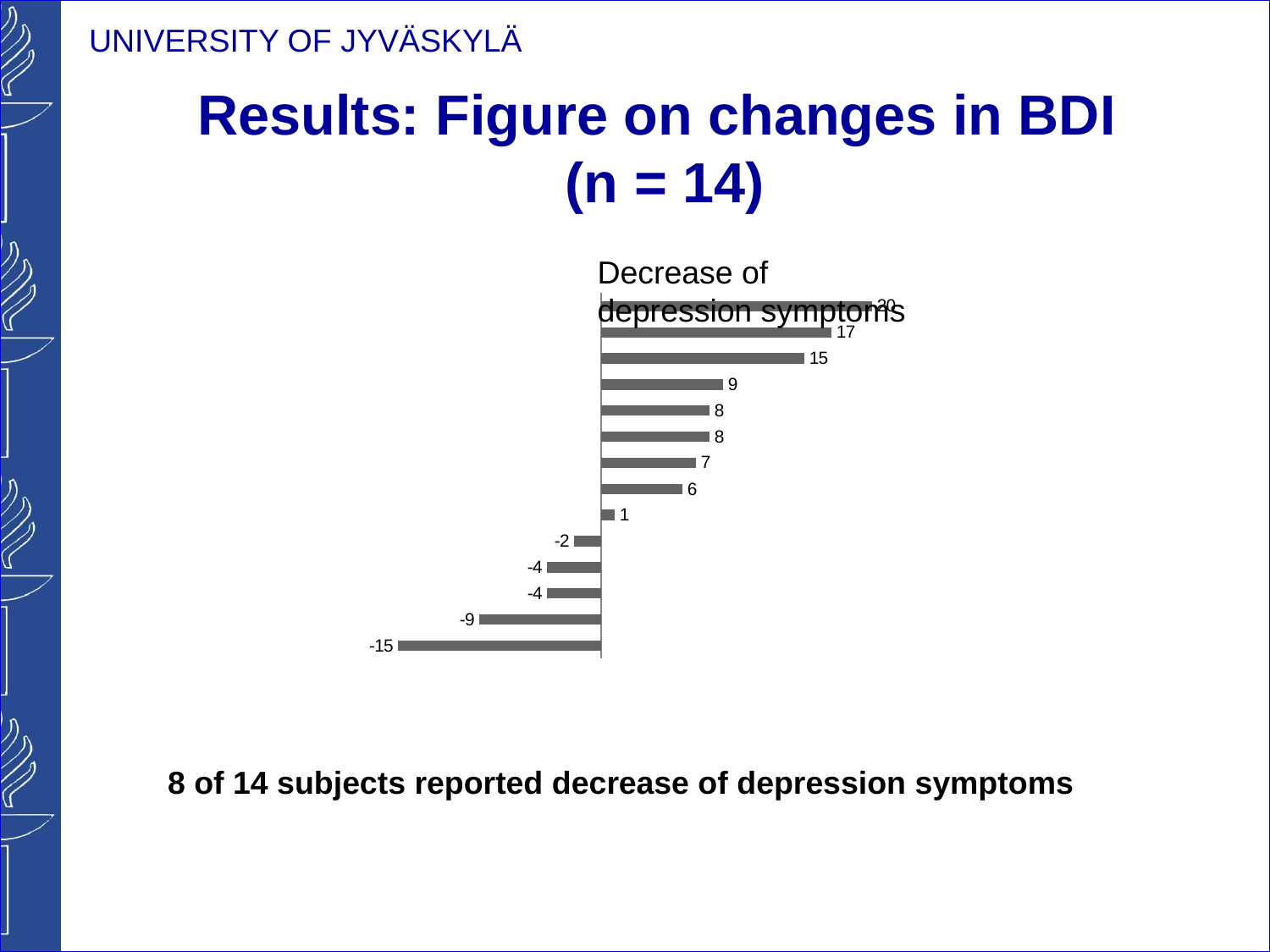
What is the title of the chart? Decrease of depression symptoms What is the difference between the second bar from the top (17) and the third bar from the top (15)? 2 How many bars in the chart have negative values? 5 What is the value of the bottom bar in the chart? -15 Which is larger: the value of the second bar from the bottom (-9) or the bottom bar (-15)? -9 How many bars are plotted in the chart? 14 What is the lowest value shown in the chart? -15 How many bars in the chart have positive values? 9 What is the smallest positive value shown in the chart? 1 What is the value of the second bar from the top? 17 What is the value of the third bar from the top? 15 What kind of chart is shown on the slide? bar chart